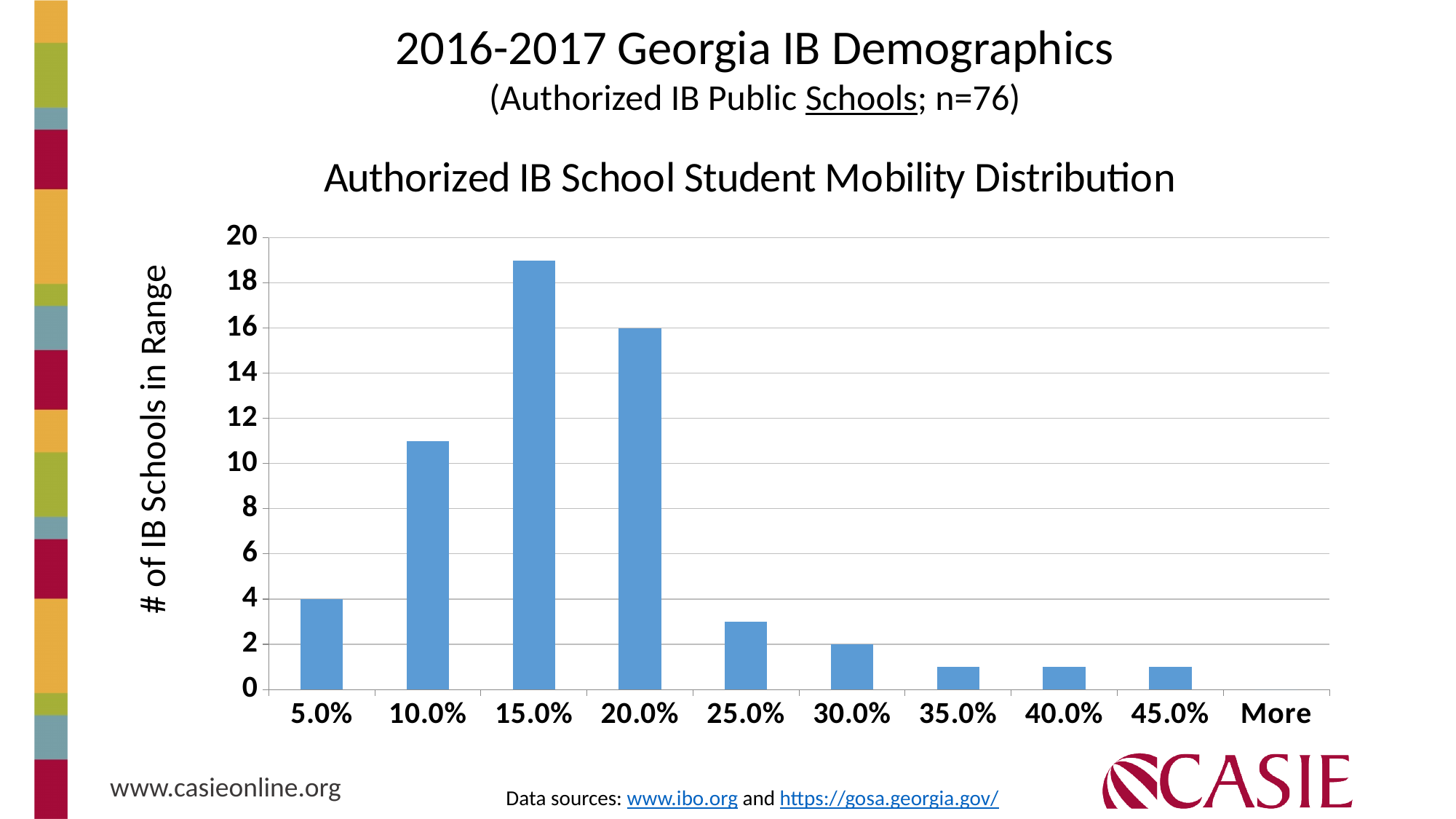
How many IB schools are in the 20.0% range? 16 How many IB schools are in the 30.0% range? 2 Which mobility range has the highest number of IB schools? 15.0% Is the value for the 35.0% range greater or less than 2? less Is the value for the 15.0% range greater or less than 18? greater Which category has the lowest number of IB schools? More What type of chart is shown on the slide? bar chart Is the value for the 10.0% range greater or less than 10? greater What is the difference between the number of schools in the 20.0% range and the 5.0% range? 12 How many IB schools are in the 5.0% range? 4 Which has more IB schools, the 10.0% range or the 20.0% range? 20.0% How many categories are shown on the x axis? 10